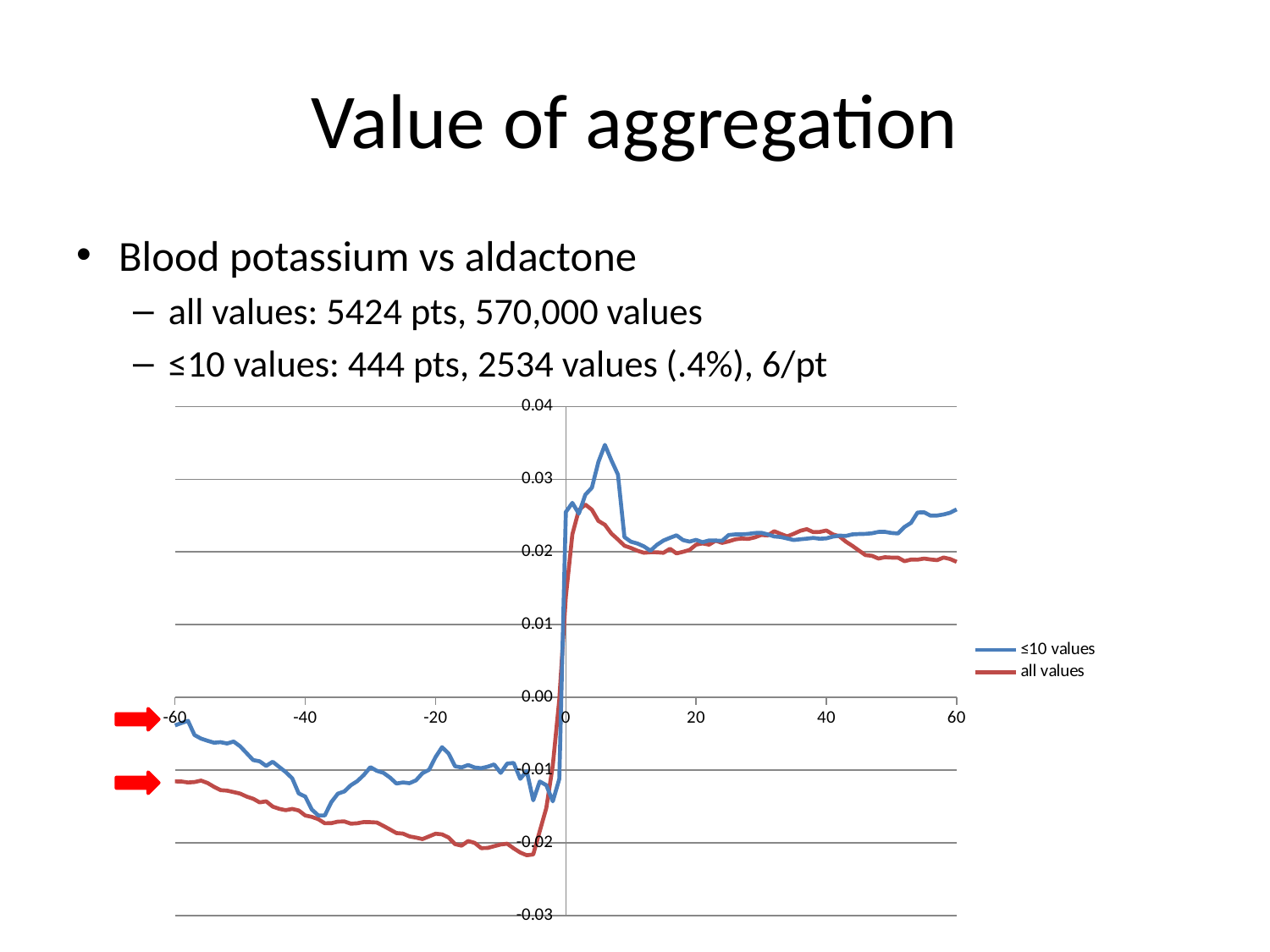
Is the value of the "≤10 values" line at x = 60 greater or less than 0.02? greater At x = -60, which series has the higher value, "≤10 values" or "all values"? ≤10 values Which series reaches the lowest value anywhere on the chart? all values What is the highest value shown on the chart's vertical axis? 0.04 How many series does the chart's legend list? 2 What kind of chart is shown on the slide? line chart What are the two series named in the chart's legend? ≤10 values and all values Is the value of the "≤10 values" line at x = -60 greater or less than -0.01? greater Is the value of the "all values" line at x = -60 greater or less than -0.01? less Does the "all values" line rise or fall as x goes from -60 to -10? fall